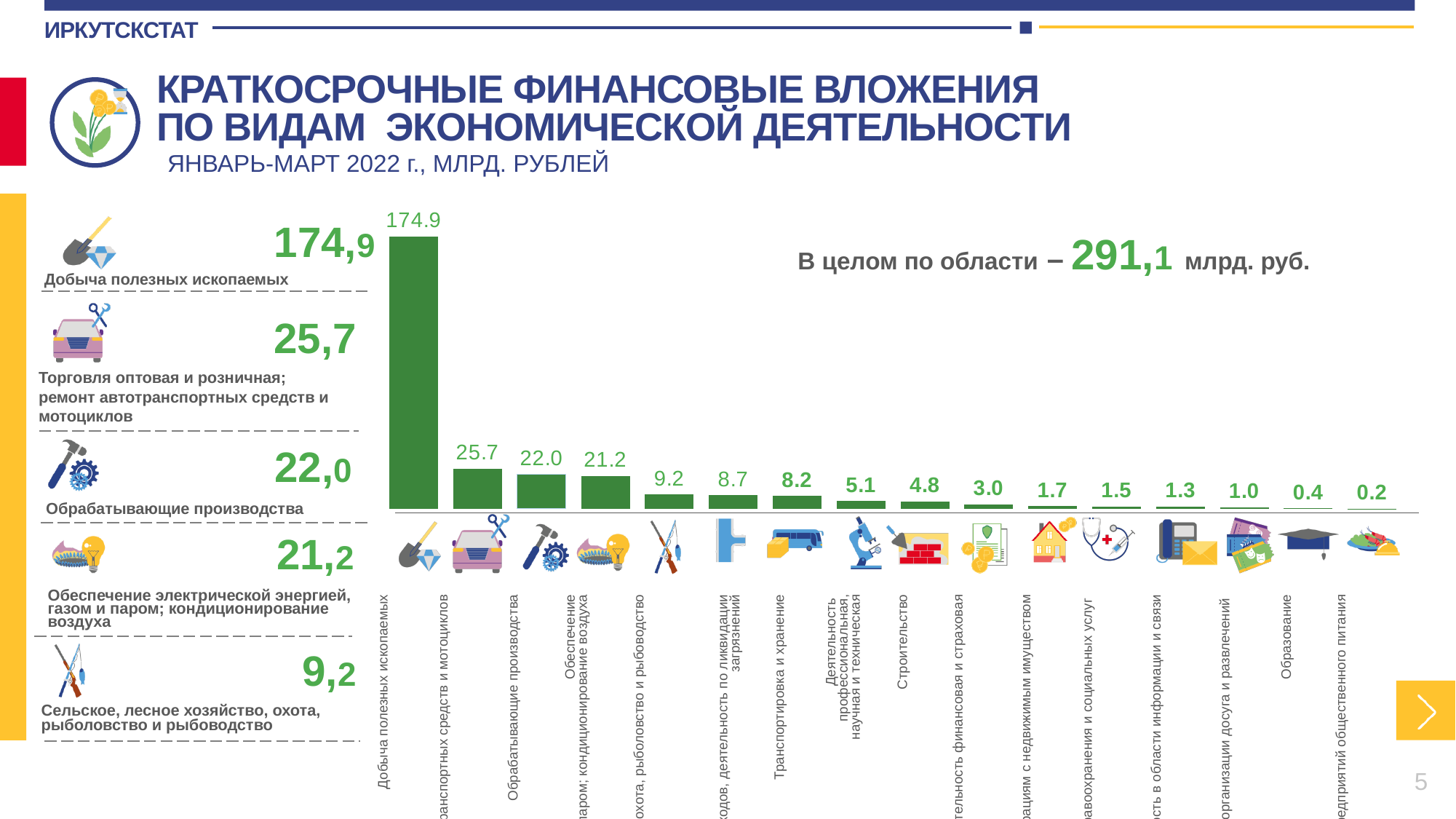
Which category has the highest value in the chart? Добыча полезных ископаемых What is the value for Транспортировка и хранение? 8.2 What is the value for Образование? 0.4 Which is larger: the value for Транспортировка и хранение or the value for Строительство? Транспортировка и хранение What is the value for Добыча полезных ископаемых? 174.9 What is the lowest value shown in the chart? 0.2 What type of chart is shown on the slide? bar chart How many bars (categories) are plotted in the chart? 16 What is the value for Обрабатывающие производства? 22.0 Do the bar values rise or fall from left to right along the x axis? fall What is the value for Строительство? 4.8 What is the difference between the values for Добыча полезных ископаемых and Обрабатывающие производства? 152.9